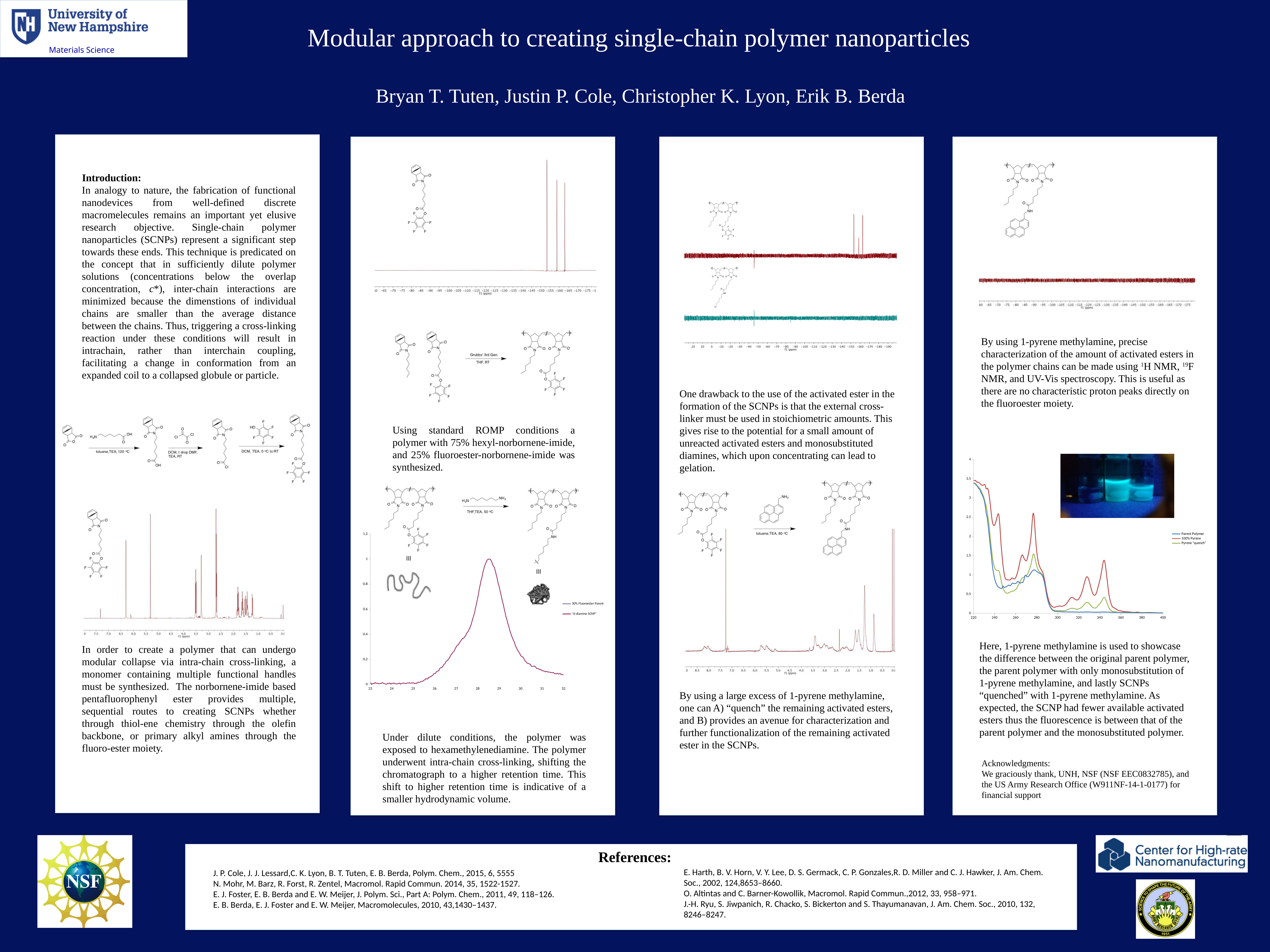
How many series does the legend of the chromatogram chart in the second column list? 2 What kind of chart is the chromatogram in the second column (x axis 23 to 32)? line chart How many series does the legend of the UV-Vis chart in the fourth column list? 3 In the UV-Vis chart in the fourth column, is the value of the Parent Polymer series at 380 greater or less than 0.5? less In the UV-Vis chart in the fourth column, which is larger around 340: the 100% Pyrene series or the Pyrene "quench" series? 100% Pyrene What kind of chart is the UV-Vis spectrum in the fourth column (x axis 220 to 400)? line chart In the UV-Vis chart in the fourth column, is the peak value of the 100% Pyrene series near 280 greater or less than 2? greater In the chromatogram chart in the second column, is the maximum value of the plotted curve greater or less than 0.8? greater In the UV-Vis chart in the fourth column, which series has the highest value around 340? 100% Pyrene In the UV-Vis chart in the fourth column, do the values generally rise or fall as the x axis goes from 220 to 400? fall What are the three legend entries of the UV-Vis chart in the fourth column? Parent Polymer, 100% Pyrene, Pyrene "quench"